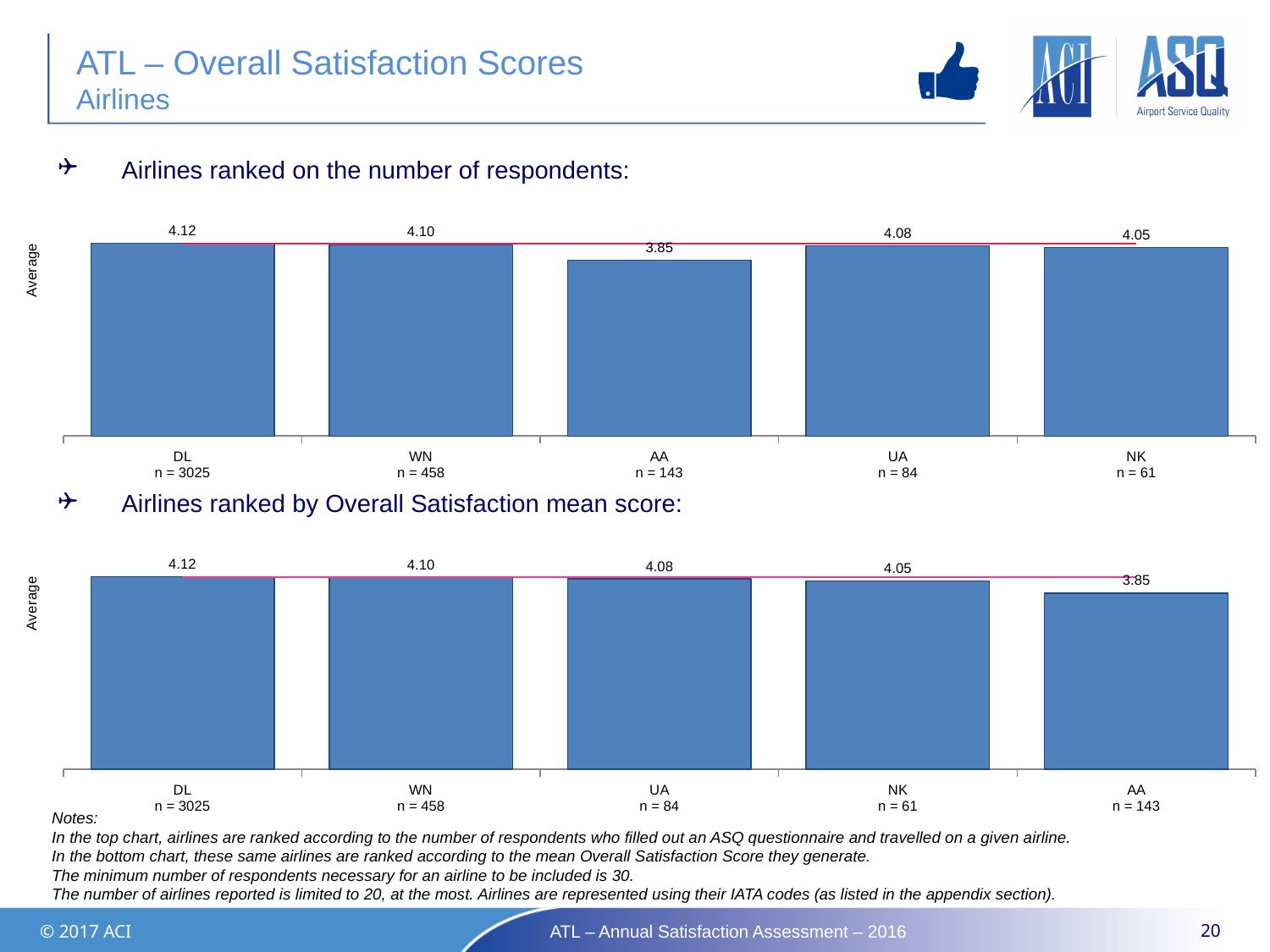
In the bottom chart (airlines ranked by Overall Satisfaction mean score), what is the difference between the average scores of WN and NK? 0.05 In the top chart (airlines ranked on the number of respondents), what is the difference between the average scores of DL and AA? 0.27 In the top chart (airlines ranked on the number of respondents), how many respondents does the label under DL show? n = 3025 How many airlines are shown in the bottom chart (airlines ranked by Overall Satisfaction mean score)? 5 In the bottom chart (airlines ranked by Overall Satisfaction mean score), do the average scores rise or fall from left to right? fall In the top chart (airlines ranked on the number of respondents), which airline has the highest average score? DL In the bottom chart (airlines ranked by Overall Satisfaction mean score), what is the average score for UA? 4.08 In the bottom chart (airlines ranked by Overall Satisfaction mean score), which airline has the lowest average score? AA What kind of chart is the top chart (airlines ranked on the number of respondents)? bar chart In the top chart (airlines ranked on the number of respondents), is the average score for WN larger or smaller than that for UA? larger In the top chart (airlines ranked on the number of respondents), what is the average score for AA? 3.85 In the top chart (airlines ranked on the number of respondents), what is the average score for DL? 4.12